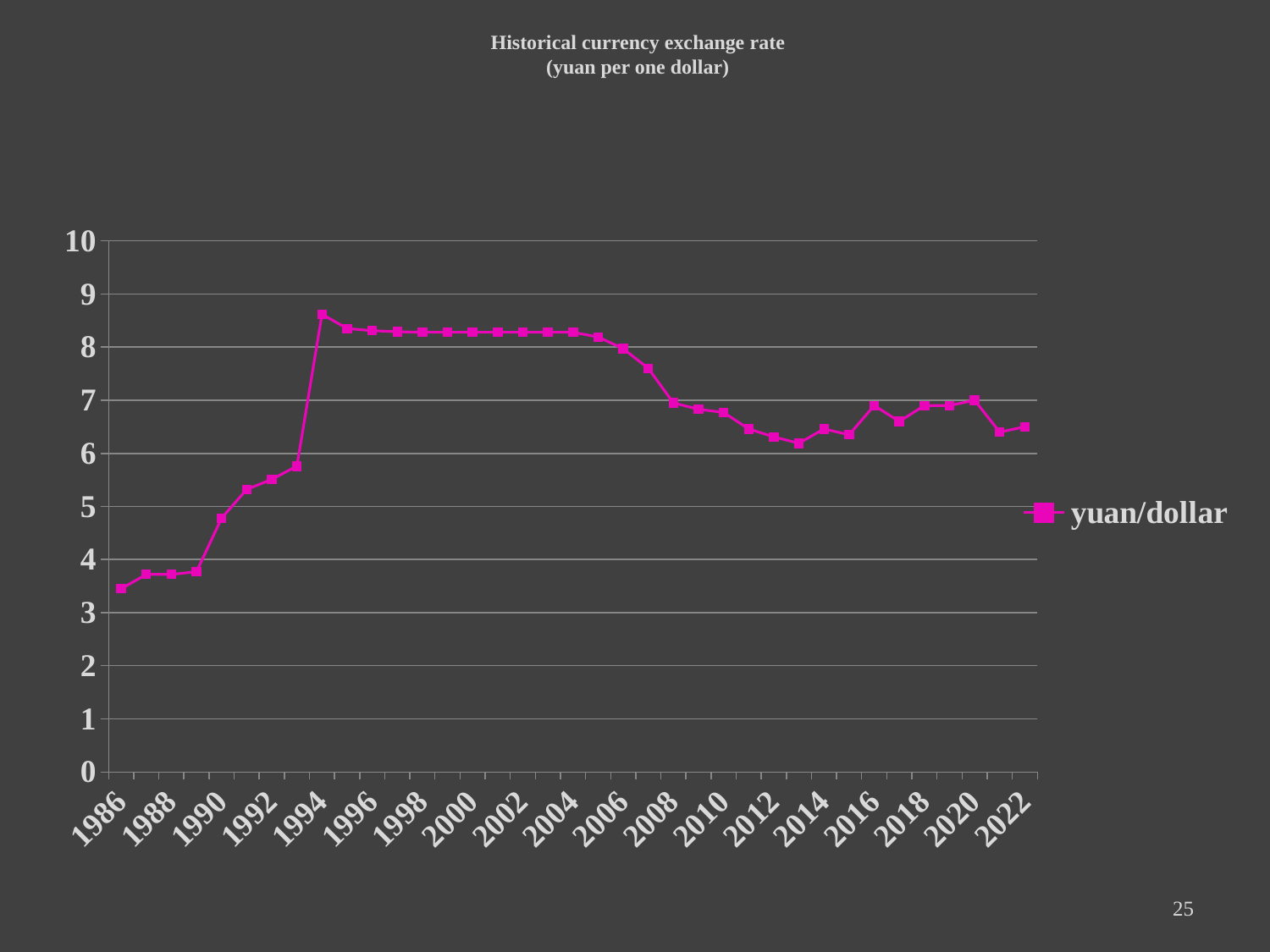
Do the values rise or fall from 1986 to 1994? rise Is the value for 2022 greater or less than 7? less In which year is the yuan/dollar rate highest? 1994 Is the value for 1994 greater or less than 8? greater What kind of chart is shown on the slide? line chart How many series does the legend list? 1 Is the value for 1986 greater or less than 4? less What is the legend entry for the plotted series? yuan/dollar Which year has the larger yuan/dollar value, 1994 or 2022? 1994 In which year is the yuan/dollar rate lowest? 1986 What is the title of the chart? Historical currency exchange rate (yuan per one dollar)